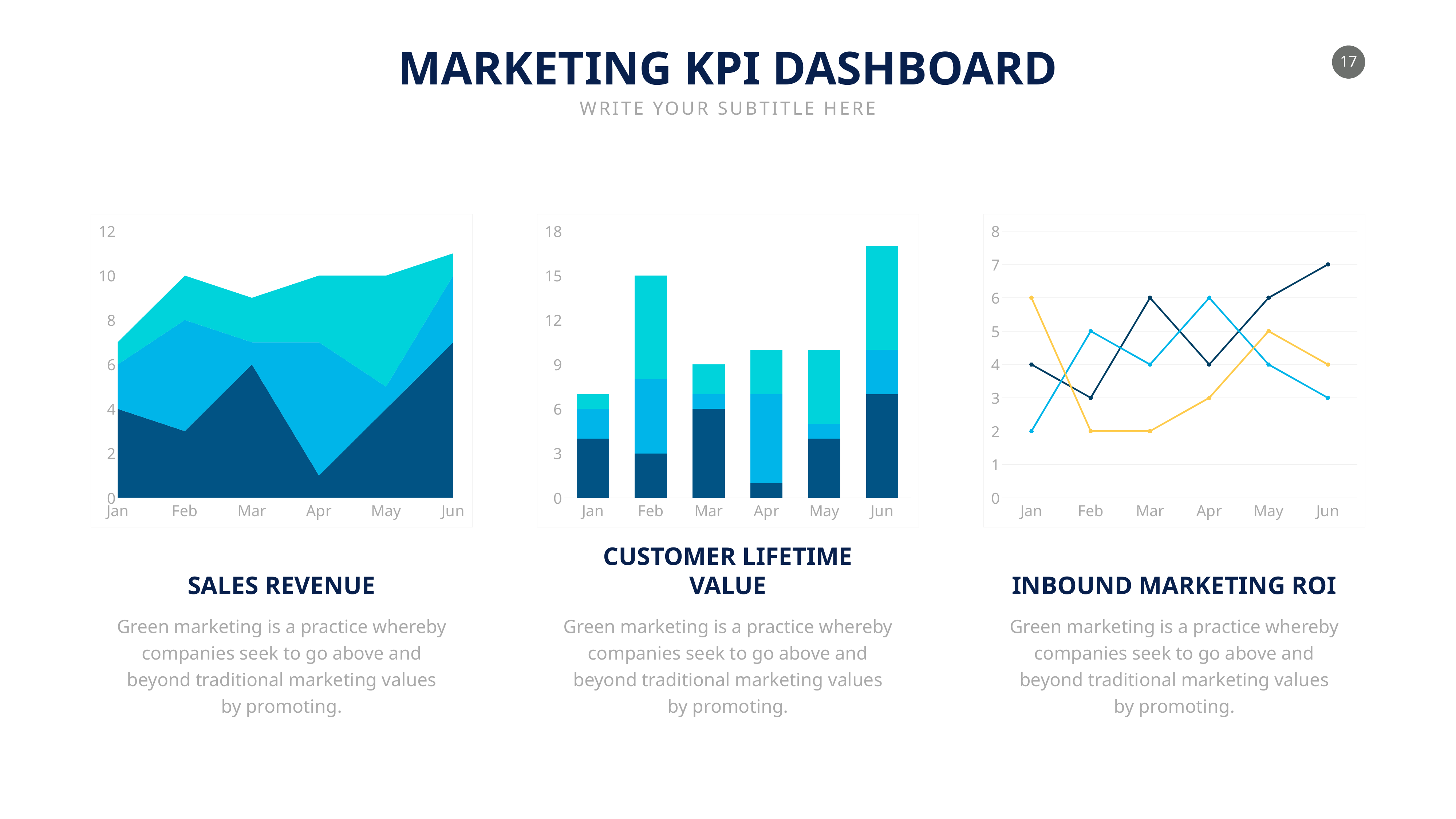
In the Customer Lifetime Value chart, is the total for Jan greater or less than 9? less What kind of chart is the Sales Revenue chart? area chart In the Customer Lifetime Value chart, which month has the tallest stacked bar? Jun In the Customer Lifetime Value chart, which bar is taller, Feb or Mar? Feb What is the highest value shown on the y axis of the Inbound Marketing ROI chart? 8 In the Customer Lifetime Value chart, is the total for Jun greater or less than 15? greater In the Customer Lifetime Value chart, what is the total height of the Feb bar? 15 What kind of chart is the Inbound Marketing ROI chart? line chart In the Sales Revenue chart, is the top of the stacked area at Jun greater or less than 10? greater In the Customer Lifetime Value chart, which month has the shortest stacked bar? Jan How many months are shown on the x axis of the Customer Lifetime Value chart? 6 What kind of chart is the Customer Lifetime Value chart? bar chart